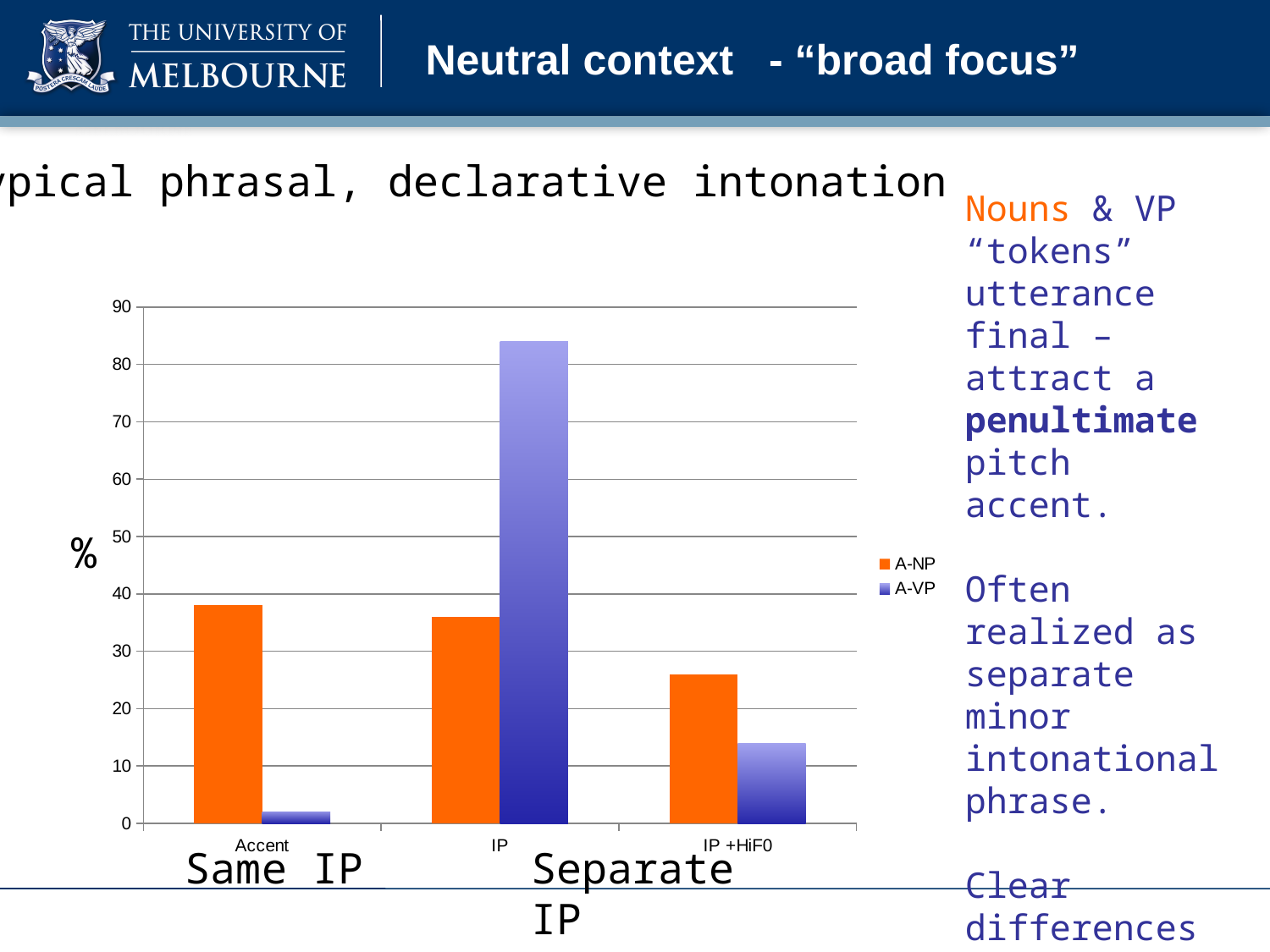
For the IP +HiF0 category, which series has the larger value, A-NP or A-VP? A-NP What kind of chart is shown on the slide? bar chart Which category has the lowest A-VP value? Accent Is the A-VP value for Accent greater or less than 10? less Is the A-VP value for IP greater or less than 80? greater What colour are the A-NP bars in the chart? orange Is the A-NP value for Accent greater or less than 30? greater Which category has the highest A-VP value? IP For the IP category, which series has the larger value, A-NP or A-VP? A-VP How many series does the chart legend list? 2 How many categories are shown along the x axis of the chart? 3 Which category has the lowest A-NP value? IP +HiF0